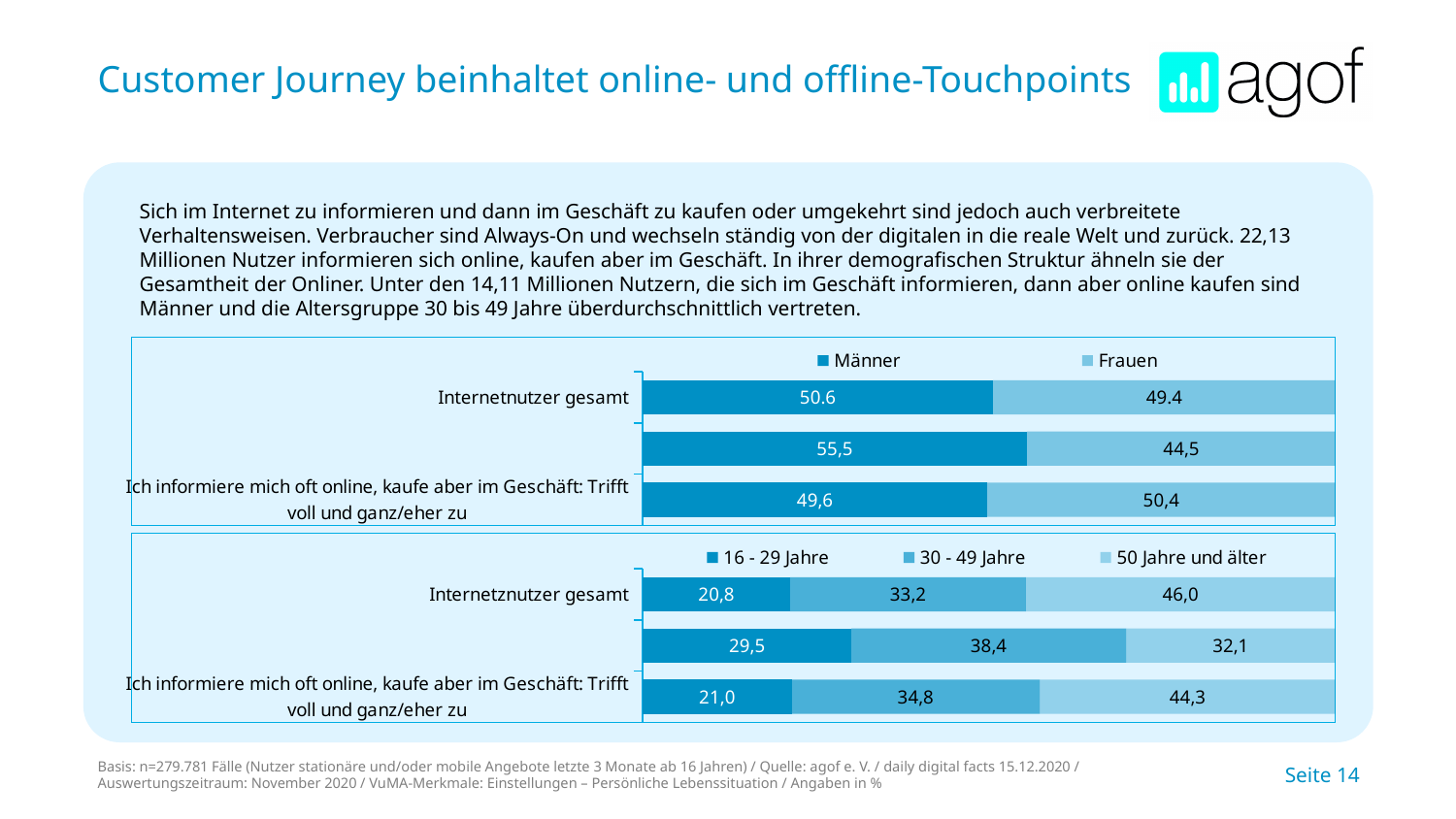
How many series does the legend of the bottom chart (age groups) list? 3 What kind of chart is the top chart (Männer/Frauen)? Stacked bar chart In the bottom chart (age groups), which age group has the largest share in the 'Internetnutzer gesamt' bar? 50 Jahre und älter In the top chart (Männer/Frauen), what is the value for Männer in the 'Internetnutzer gesamt' bar? 50.6 In the bottom chart (age groups), what is the value for '50 Jahre und älter' in the 'Internetnutzer gesamt' bar? 46,0 In the bottom chart (age groups), what is the difference in the '30 - 49 Jahre' value between the bar 'Ich informiere mich oft online, kaufe aber im Geschäft: Trifft voll und ganz/eher zu' and the 'Internetnutzer gesamt' bar? 1,6 How many series does the legend of the top chart (Männer/Frauen) list? 2 How many bars are shown in the top chart (Männer/Frauen)? 3 In the top chart (Männer/Frauen), what is the value for Frauen in the bar 'Ich informiere mich oft online, kaufe aber im Geschäft: Trifft voll und ganz/eher zu'? 50,4 In the bottom chart (age groups), what is the value for '16 - 29 Jahre' in the bar 'Ich informiere mich oft online, kaufe aber im Geschäft: Trifft voll und ganz/eher zu'? 21,0 What is the total of the 'Internetnutzer gesamt' bar in the top chart (Männer/Frauen)? 100 In the top chart (Männer/Frauen), which is larger in the bar 'Ich informiere mich oft online, kaufe aber im Geschäft: Trifft voll und ganz/eher zu': Männer or Frauen? Frauen